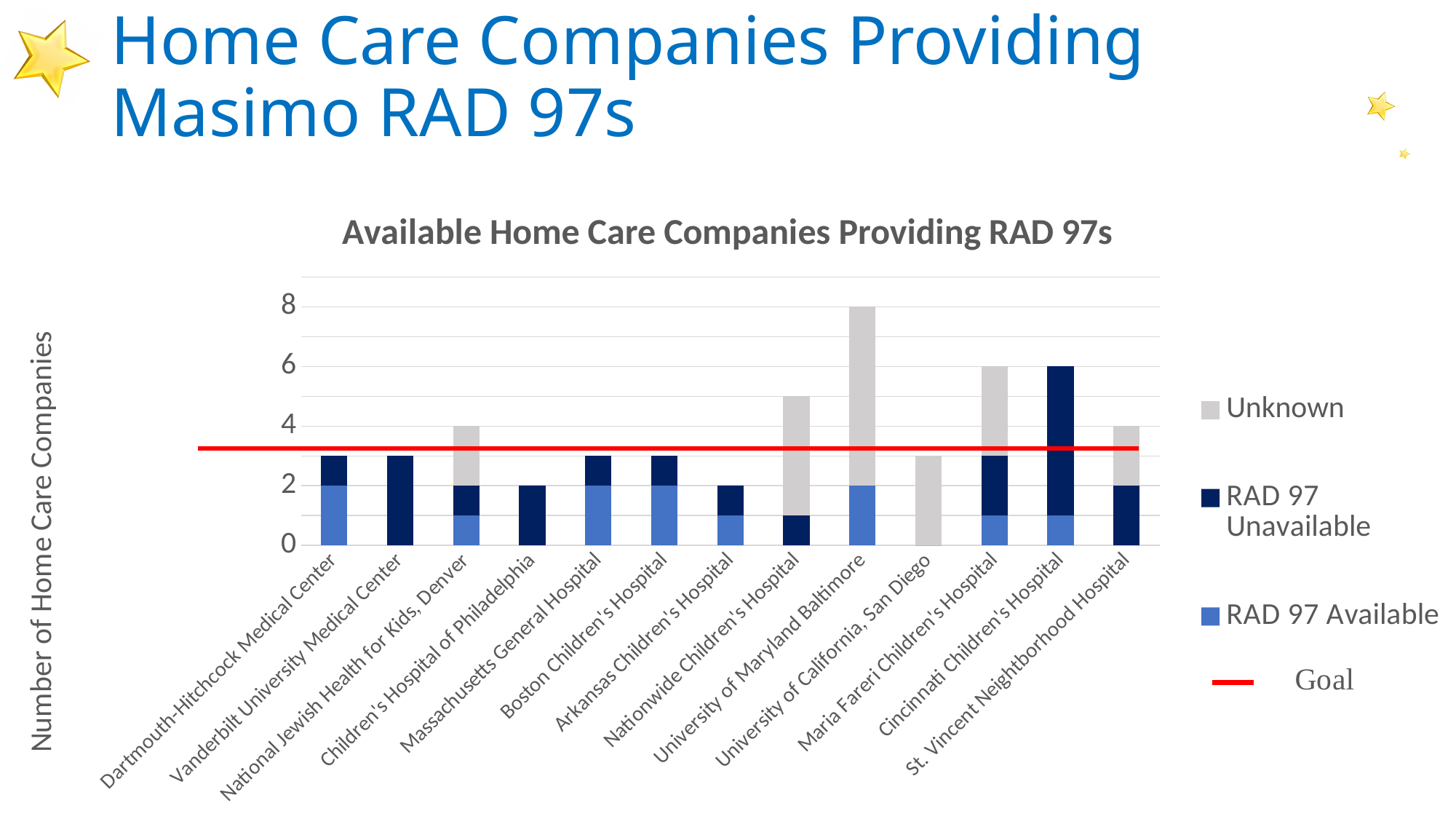
Is the total bar height for Nationwide Children's Hospital greater or less than 4? greater What is the title of the chart? Available Home Care Companies Providing RAD 97s What is the total bar height for Cincinnati Children's Hospital? 6 What kind of chart is shown on the slide? Stacked bar chart Which bar is taller: University of Maryland Baltimore or Cincinnati Children's Hospital? University of Maryland Baltimore What does the red horizontal line on the chart represent? Goal How many entries does the chart legend list? 4 How many hospitals are shown along the x axis of the chart? 13 Is the total bar height for Dartmouth-Hitchcock Medical Center greater or less than 4? less Which hospital has the tallest bar in the chart? University of Maryland Baltimore What is the total bar height for University of Maryland Baltimore? 8 What is the RAD 97 Unavailable value for Children's Hospital of Philadelphia? 2